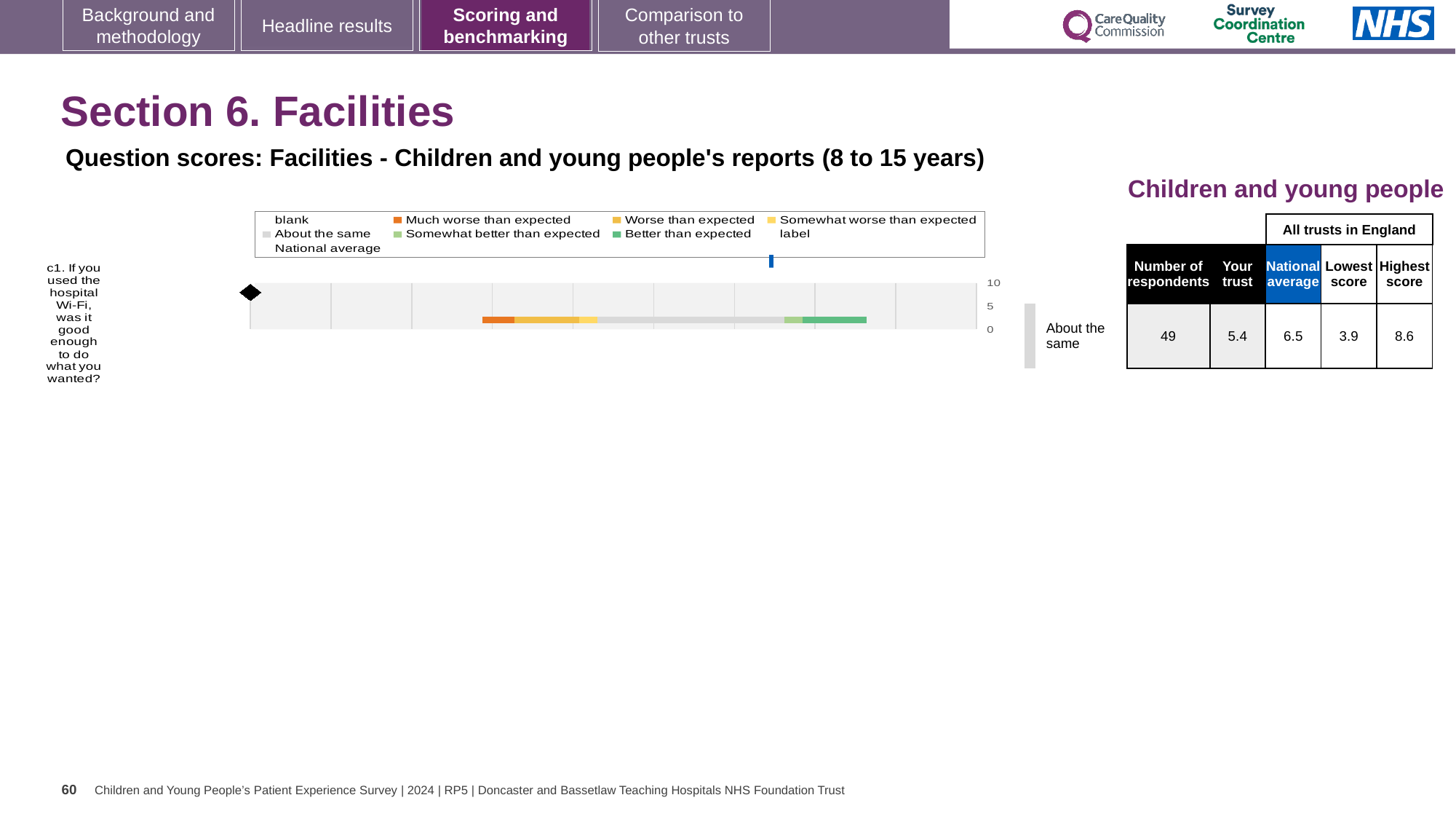
What is the difference between the national average and the 'Your trust' score for question c1? 1.1 What is the difference between the highest score and the lowest score for question c1? 4.7 Which colour in the legend represents 'Much worse than expected'? Orange How many survey questions (categories) are plotted in the chart? 1 Which is larger for question c1: the 'Your trust' score or the national average? National average What is the national average score for question c1? 6.5 What benchmark category is the trust's result for question c1 assigned to? About the same How many respondents answered question c1? 49 What is the highest score among all trusts in England for question c1? 8.6 What kind of chart is shown on the slide for question c1? bar chart What is the 'Your trust' score for question c1 about the hospital Wi-Fi? 5.4 What is the lowest score among all trusts in England for question c1? 3.9